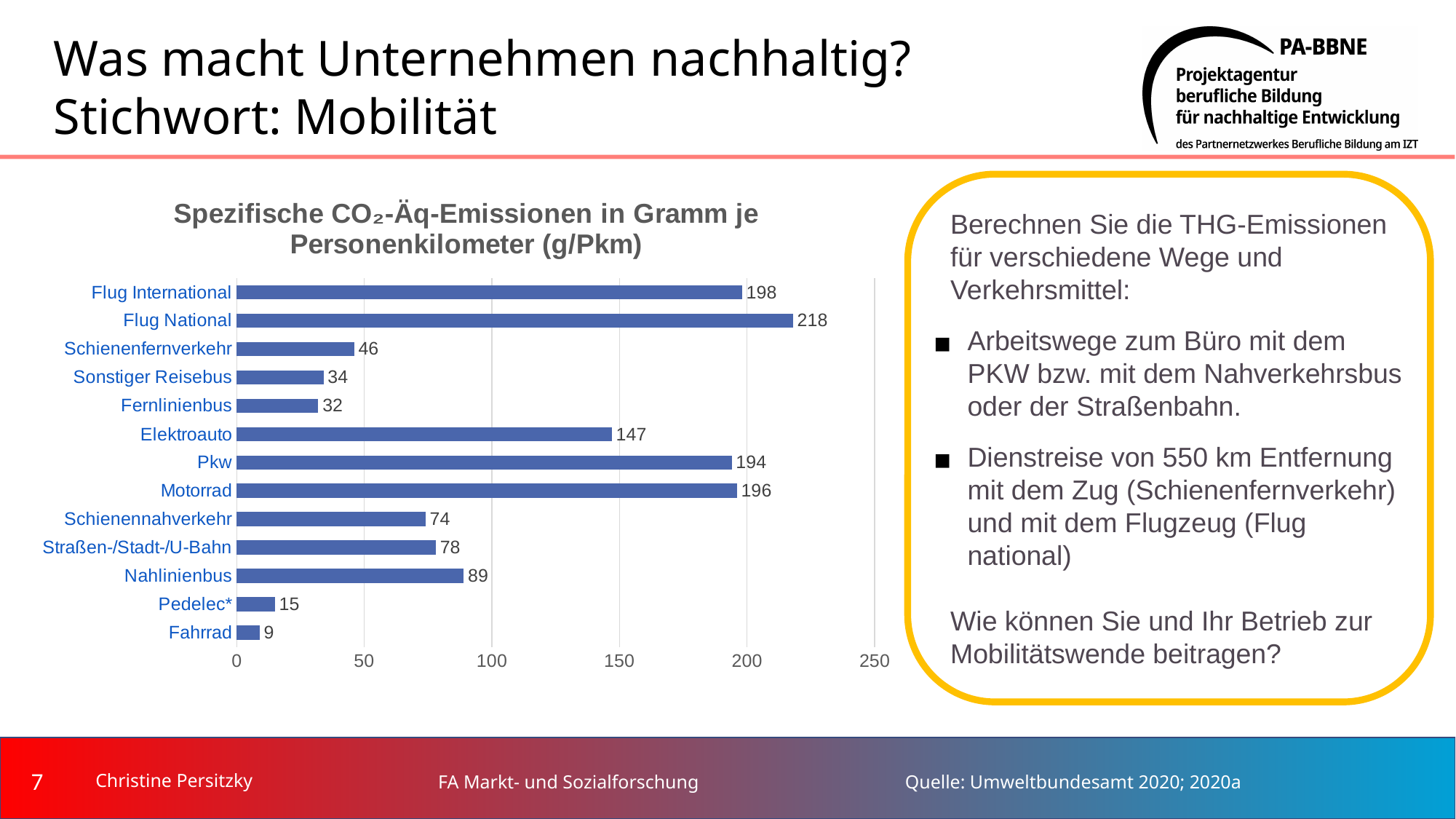
What is the difference between the values for Flug National and Schienenfernverkehr? 172 How many categories are shown in the chart? 13 What is the value for Elektroauto? 147 Which category has the lowest value? Fahrrad What is the difference between the values for Pkw and Elektroauto? 47 Is the value for Motorrad greater or less than 150? greater What is the value for Flug National? 218 What is the value for Nahlinienbus? 89 What kind of chart is shown on the slide? bar chart What is the title of the chart? Spezifische CO₂-Äq-Emissionen in Gramm je Personenkilometer (g/Pkm) Which is larger, the value for Schienennahverkehr or the value for Straßen-/Stadt-/U-Bahn? Straßen-/Stadt-/U-Bahn Which category has the highest value? Flug National